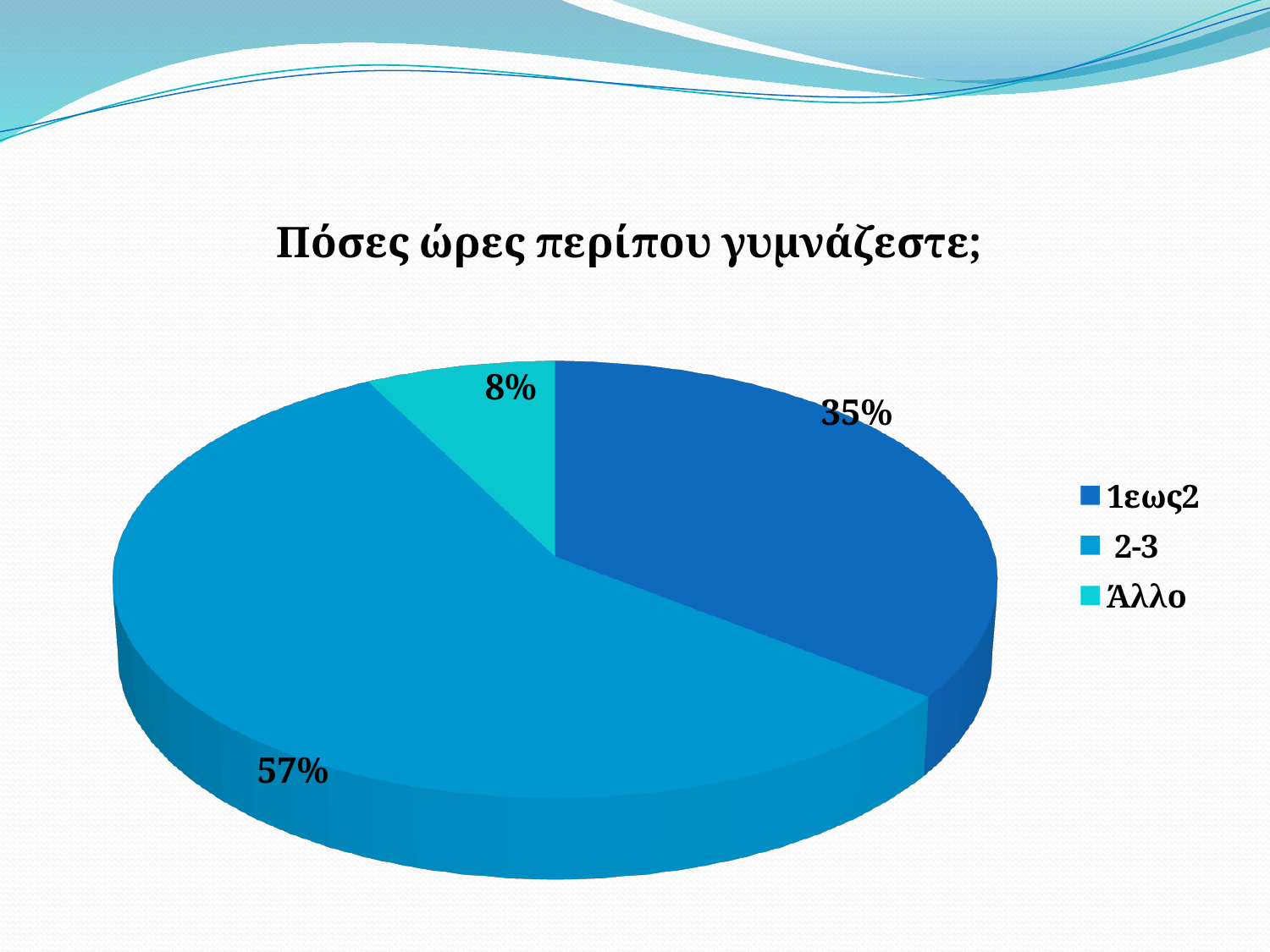
Which is larger, the "1εως2" slice or the "Άλλο" slice? 1εως2 What share of the pie does the "Άλλο" slice represent? 8% Which category is shown in the lightest (turquoise) colour in the legend? Άλλο Which category has the largest slice of the pie? 2-3 What share of the pie does the "1εως2" slice represent? 35% What share of the pie does the "2-3" slice represent? 57% What is the difference in percentage points between the "1εως2" slice and the "Άλλο" slice? 27 What is the title of the chart? Πόσες ώρες περίπου γυμνάζεστε; What kind of chart is shown on the slide? Pie chart Which category has the smallest slice of the pie? Άλλο What is the difference in percentage points between the "2-3" slice and the "1εως2" slice? 22 How many categories does the pie chart show? 3